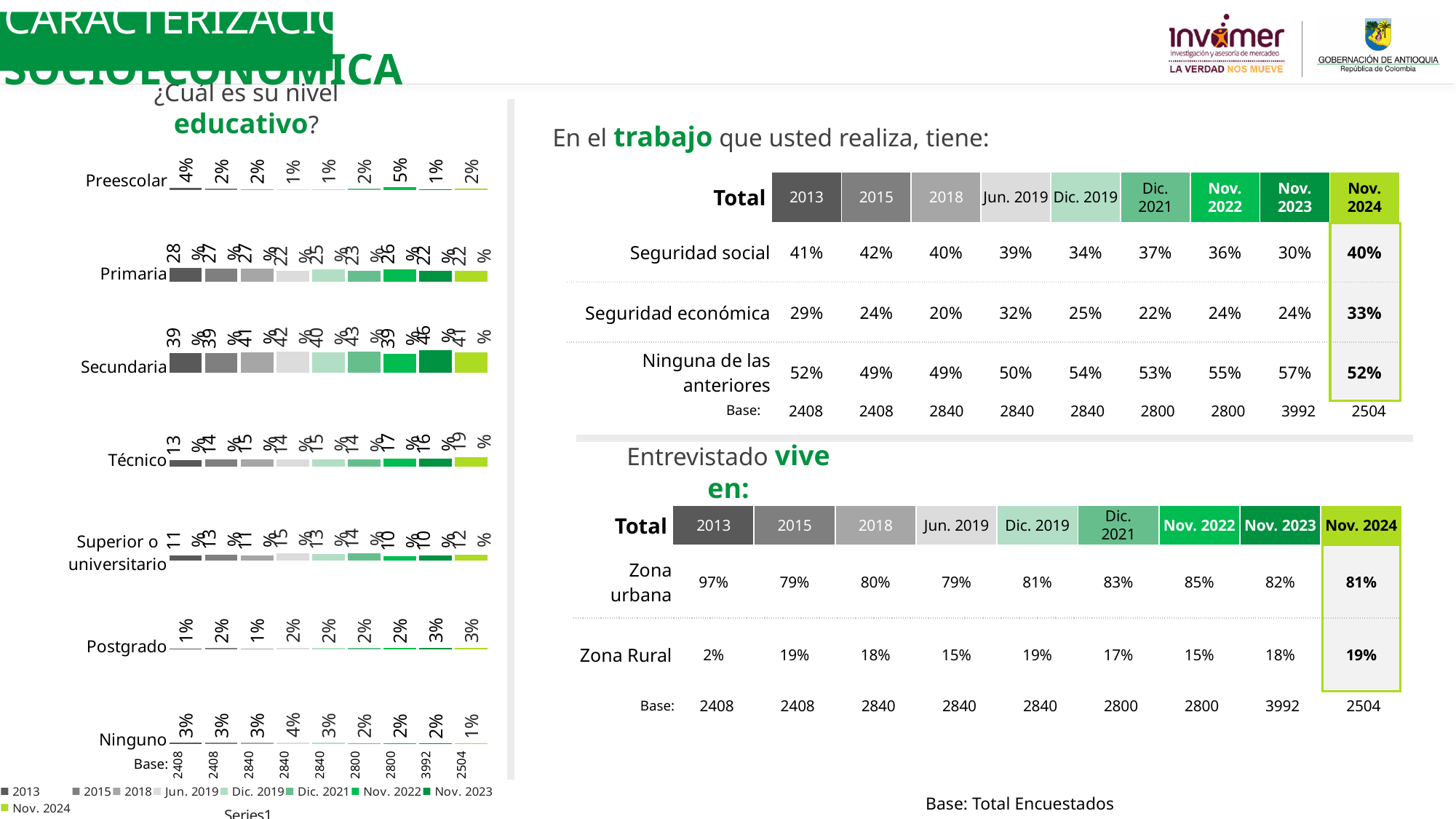
In the '¿Cuál es su nivel educativo?' chart, what is the value for Postgrado in Nov. 2023? 3% In the '¿Cuál es su nivel educativo?' chart, which education level has the highest value for 2013? Secundaria In the '¿Cuál es su nivel educativo?' chart, what is the value for Preescolar in Nov. 2022? 5% In the '¿Cuál es su nivel educativo?' chart, does the value for Técnico rise or fall from 2013 to Nov. 2024? Rise In the '¿Cuál es su nivel educativo?' chart, which is larger in Nov. 2024: Técnico or Superior o universitario? Técnico In the '¿Cuál es su nivel educativo?' chart, which survey wave has the highest value for Secundaria? Nov. 2023 In the '¿Cuál es su nivel educativo?' chart, what is the value for Secundaria in Nov. 2024? 41% What kind of chart is used for '¿Cuál es su nivel educativo?'? Bar chart In the '¿Cuál es su nivel educativo?' chart, what is the difference between the Primaria value for 2013 and for Nov. 2024? 6 percentage points How many education level categories are shown in the '¿Cuál es su nivel educativo?' chart? 7 In the '¿Cuál es su nivel educativo?' chart, what is the value for Técnico in Nov. 2024? 19% In the '¿Cuál es su nivel educativo?' chart, which survey wave has the lowest value for Ninguno? Nov. 2024